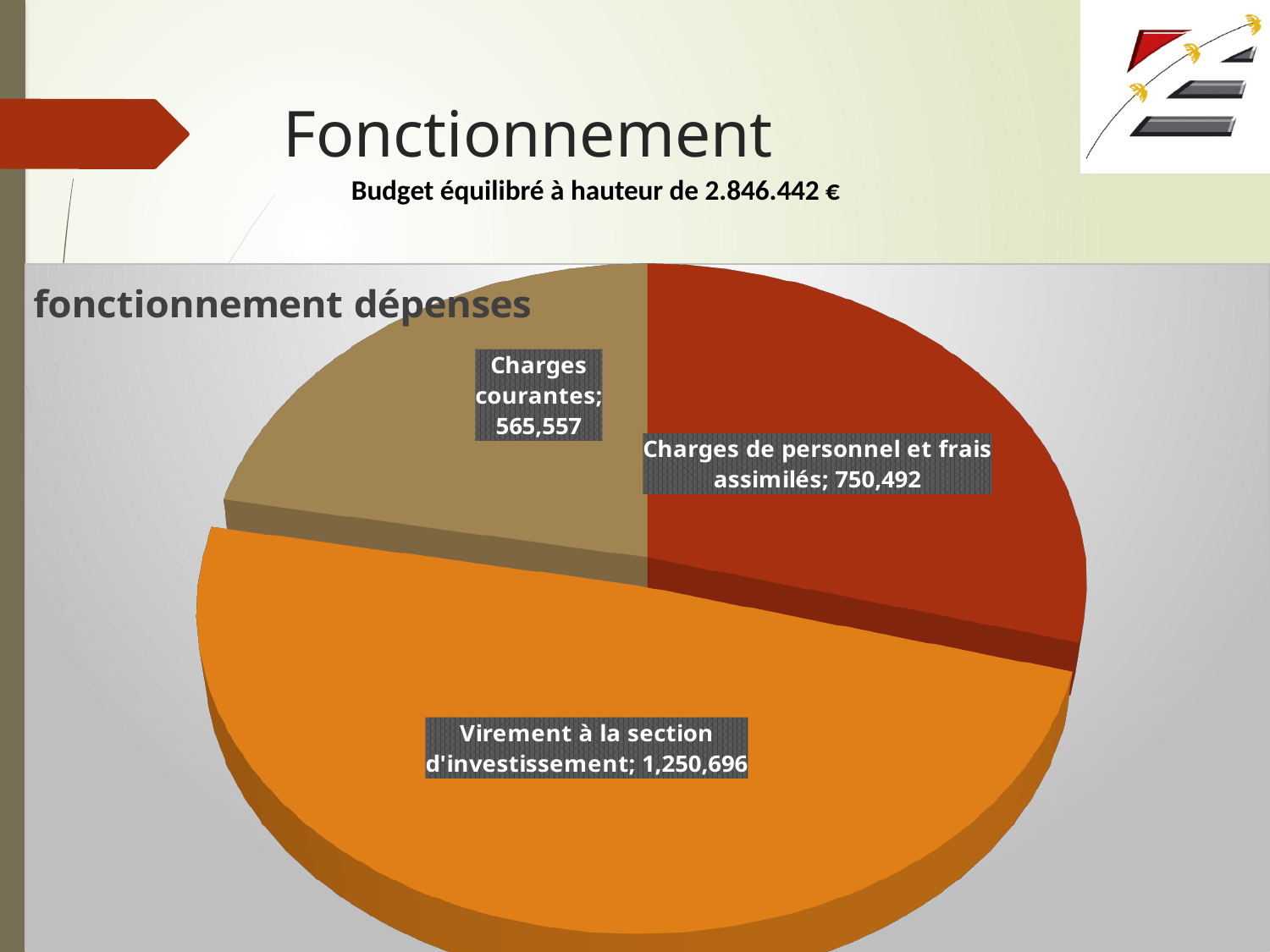
What colour is the slice for Virement à la section d'investissement? Orange What is the value for Charges courantes in the pie chart? 565,557 How many categories are shown in the pie chart? 3 What is the difference between Charges de personnel et frais assimilés and Charges courantes? 184,935 Which category has the smallest slice of the pie chart? Charges courantes What is the difference between Virement à la section d'investissement and Charges de personnel et frais assimilés? 500,204 What is the title of the chart? fonctionnement dépenses Which is larger, Charges courantes or Charges de personnel et frais assimilés? Charges de personnel et frais assimilés What is the value for Virement à la section d'investissement? 1,250,696 What is the value for Charges de personnel et frais assimilés? 750,492 What kind of chart is shown on the slide? Pie chart Which category has the largest slice of the pie chart? Virement à la section d'investissement